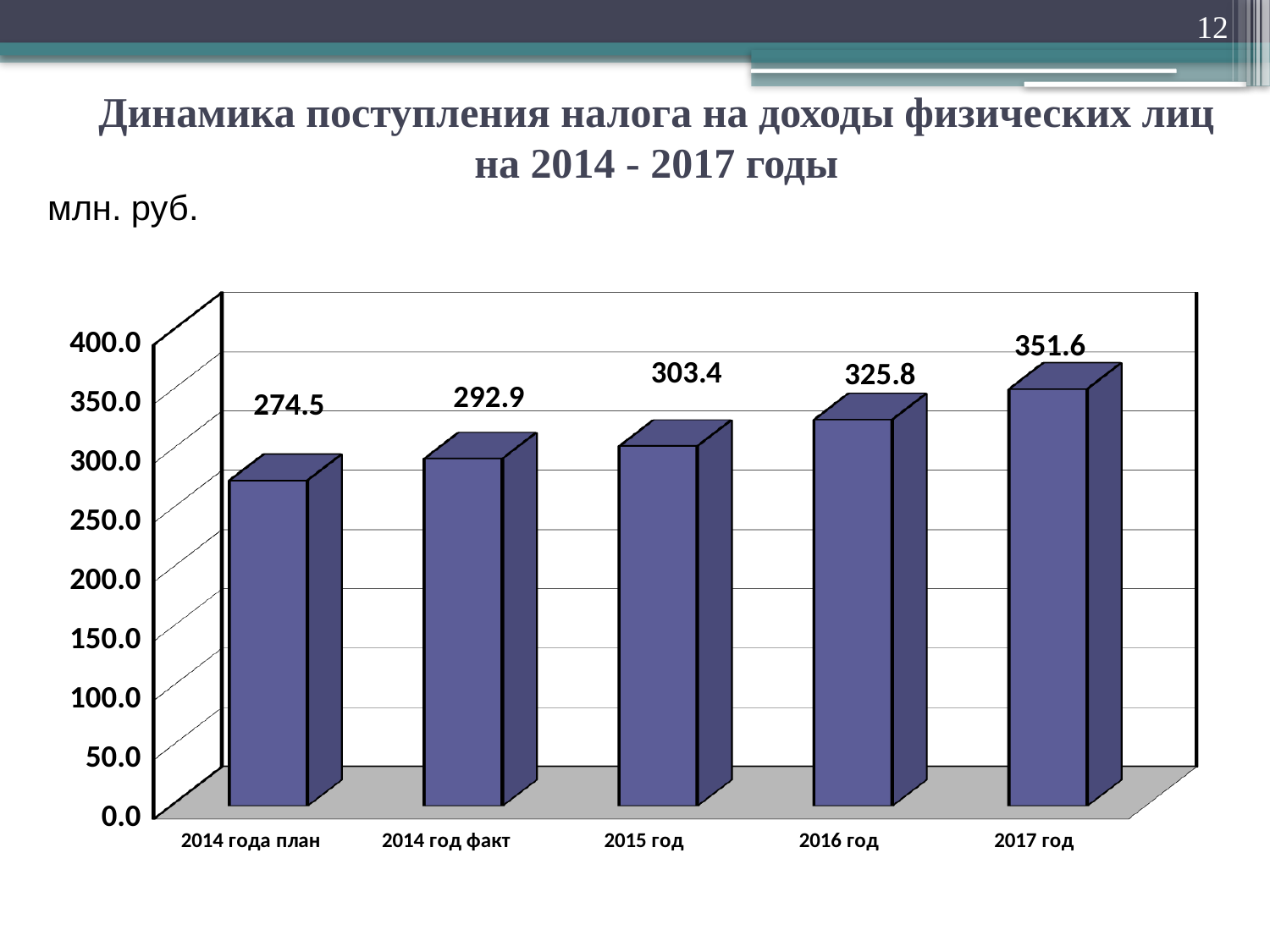
Which category has the highest value? 2017 год What is the value for 2016 год? 325.8 Which is larger, the value for 2015 год or the value for 2014 год факт? 2015 год How many categories are shown on the x axis? 5 Which category has the lowest value? 2014 года план Do the values rise or fall from left to right along the x axis? rise What is the value for 2014 года план? 274.5 What is the difference between the values for 2017 год and 2016 год? 25.8 What is the difference between the values for 2014 год факт and 2014 года план? 18.4 What kind of chart is shown on the slide? bar chart What is the value for 2014 год факт? 292.9 Is the value for 2017 год greater or less than 300.0? greater